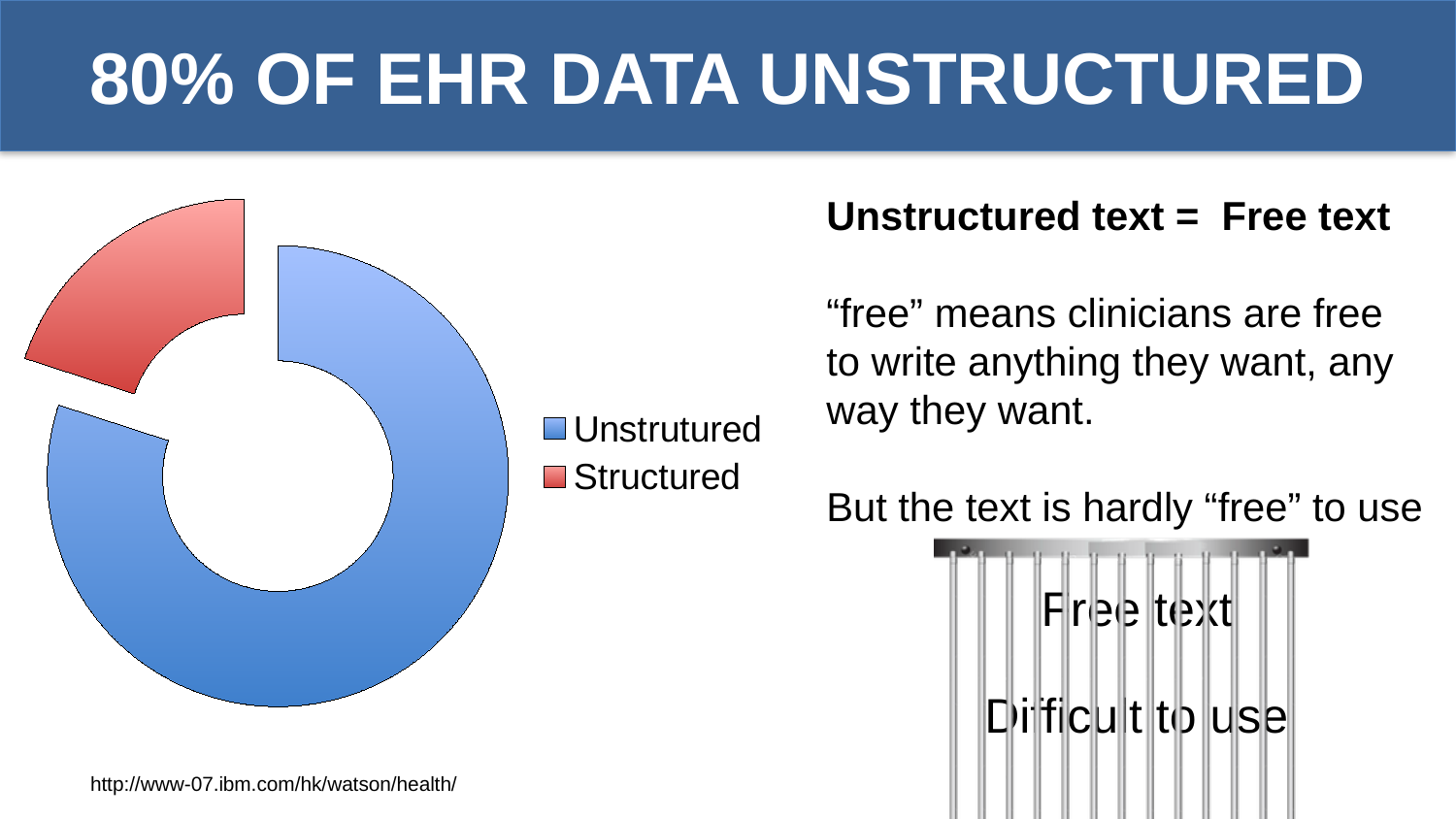
What are the two legend entries of the chart? Unstrutured and Structured How many categories does the chart show? 2 Which slice is larger, Unstrutured or Structured? Unstrutured According to the slide title, what percentage of EHR data is unstructured? 80% Which category has the smallest slice in the chart? Structured What kind of chart is shown on the slide? doughnut chart Which category has the largest slice in the chart? Unstrutured What colour is the Structured slice in the chart? red How many entries does the chart's legend list? 2